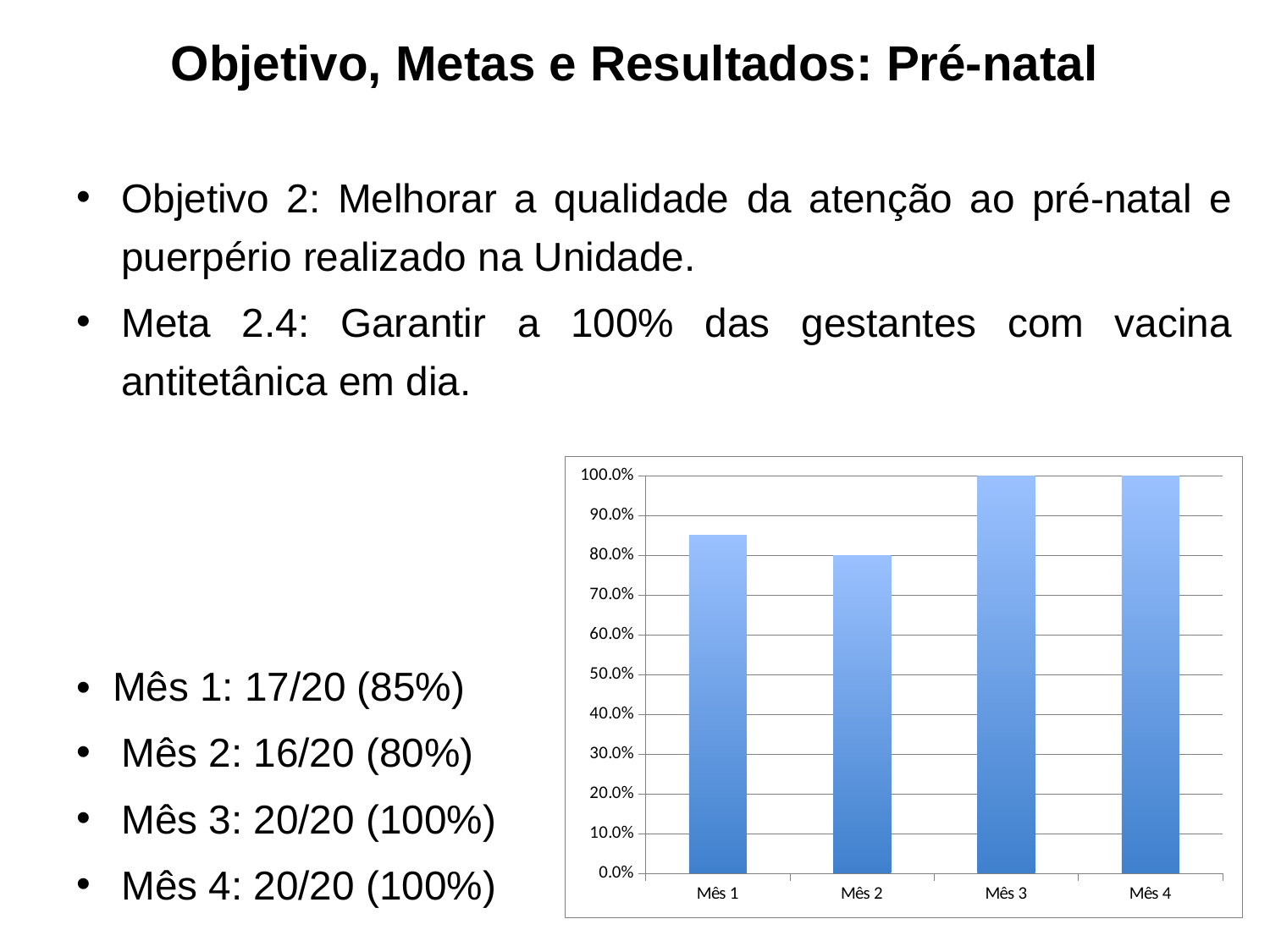
What is the difference between the values for Mês 3 and Mês 2? 20.0% Which is larger, the value for Mês 1 or the value for Mês 2? Mês 1 What is the value for Mês 4 in the chart? 100.0% What colour are the bars in the chart? blue Is the value for Mês 1 greater or less than 80.0%? greater Is the value for Mês 1 greater or less than 90.0%? less How many categories are shown on the x axis of the chart? 4 Which category has the lowest value in the chart? Mês 2 What kind of chart is shown on the slide? bar chart What is the value for Mês 2 in the chart? 80.0% What is the value for Mês 3 in the chart? 100.0% Do the values rise or fall from Mês 2 to Mês 4? rise